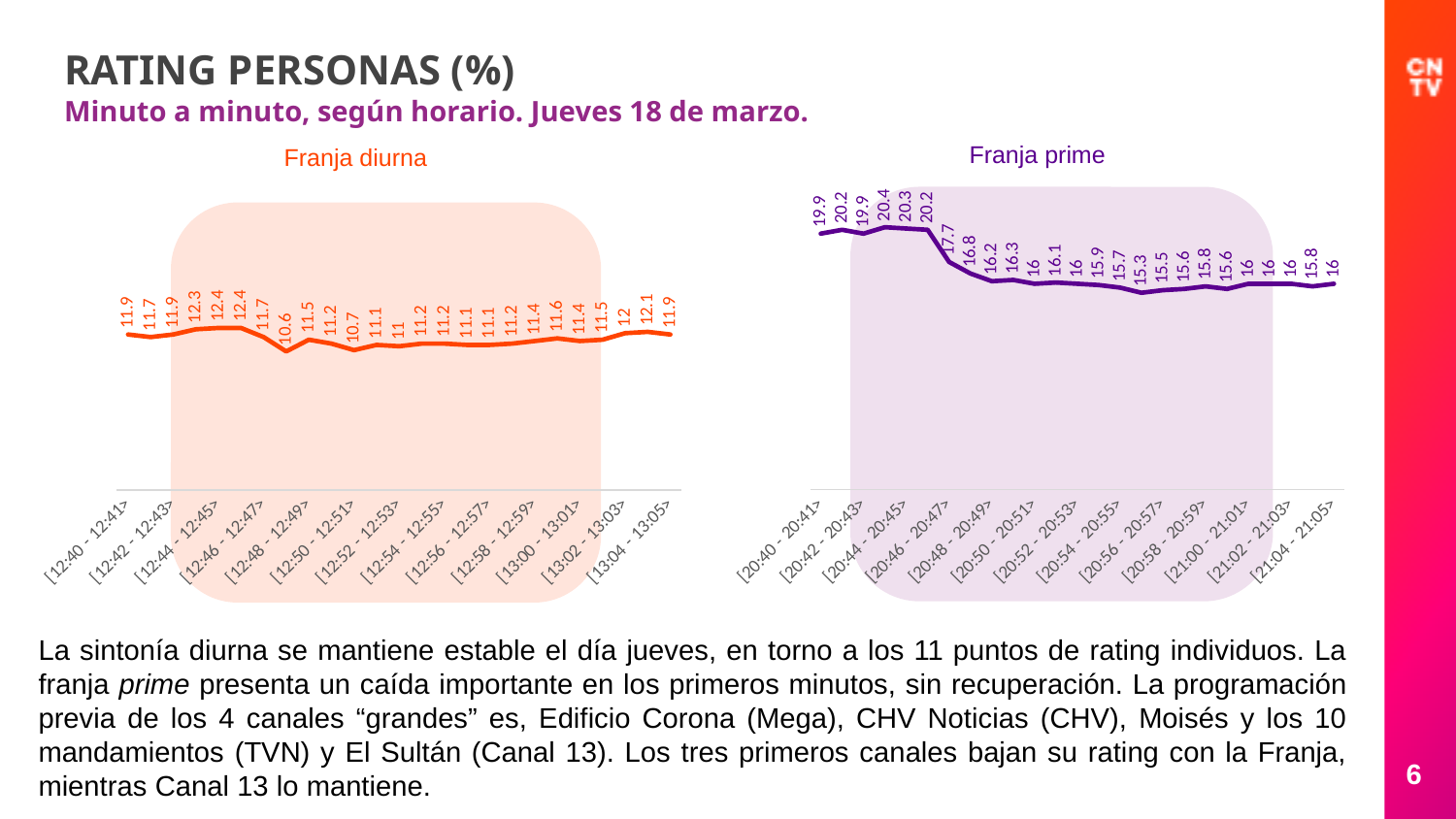
In the Franja prime chart, what is the value of the first point (20:40 - 20:41)? 19.9 In the Franja diurna chart, what is the highest rating value shown? 12.4 What kind of chart is used for the Franja diurna data? line chart In the Franja prime chart, do the values overall rise or fall from left to right? fall In the Franja diurna chart, what is the lowest rating value shown? 10.6 In the Franja diurna chart, what is the difference between the highest and lowest values? 1.8 In the Franja diurna chart, what is the value of the first point (12:40 - 12:41)? 11.9 In the Franja prime chart, what is the lowest rating value shown? 15.3 In the Franja prime chart, what is the value of the last point (21:04 - 21:05)? 16 Which chart has the higher first value, Franja diurna or Franja prime? Franja prime In the Franja prime chart, what is the highest rating value shown? 20.4 In the Franja prime chart, what is the difference between the highest and lowest values? 5.1